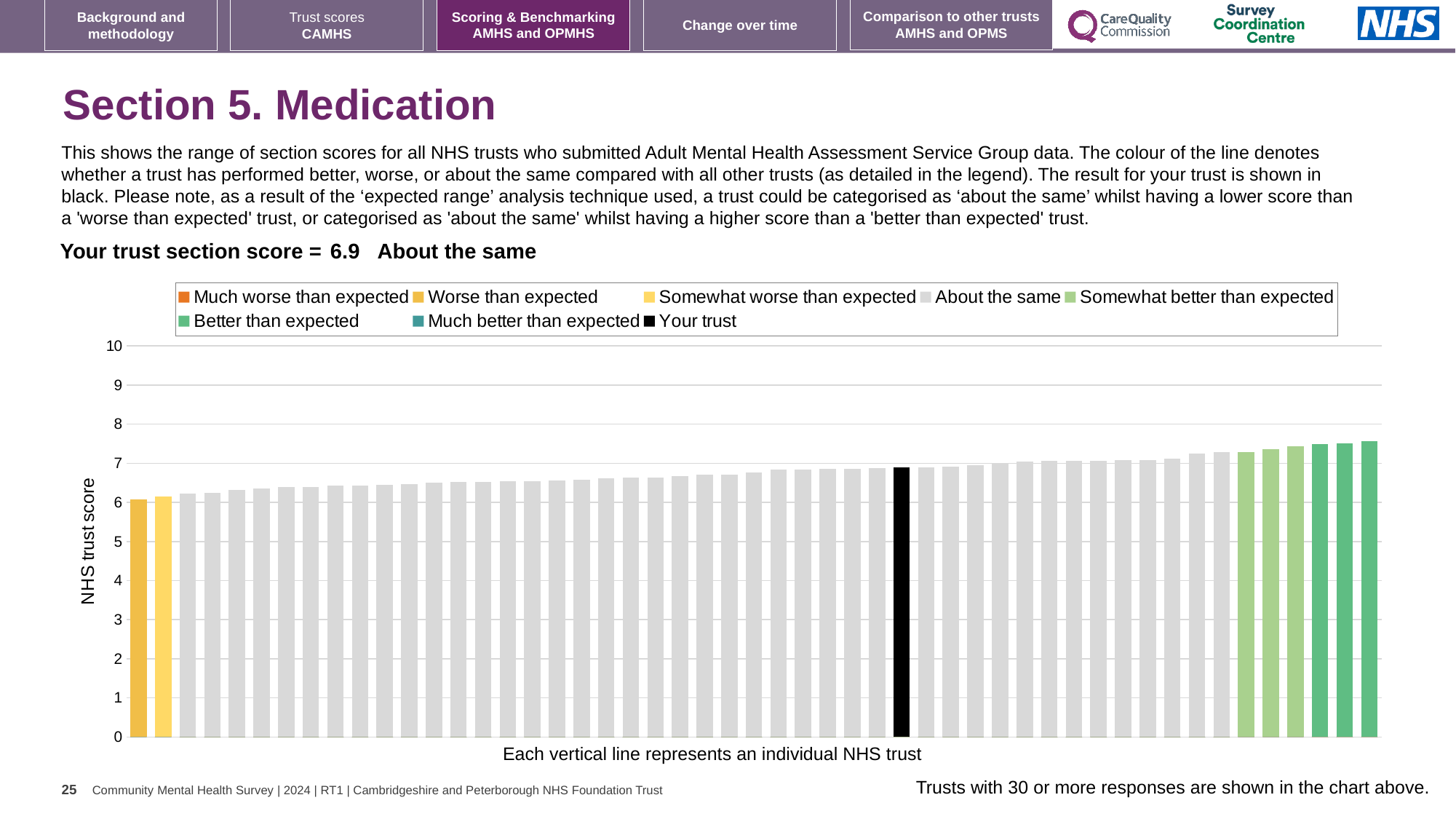
What colour is used for the bar representing your trust? Black Is the value of the lowest bar in the chart greater or less than 5? greater How is your trust's section score categorised compared with other trusts? About the same What is the section score for your trust shown on the slide? 6.9 How many entries does the chart legend list? 8 How many bars are coloured in the darker green 'Better than expected' colour? 3 Is the value of the highest bar in the chart greater or less than 8? less What kind of chart is shown on the slide? Bar chart Is the value for your trust (the black bar) greater or less than 6? greater Do the bar values rise or fall from left to right along the x axis? rise What is the label on the vertical axis of the chart? NHS trust score Is the rightmost bar higher or lower than your trust's black bar? higher